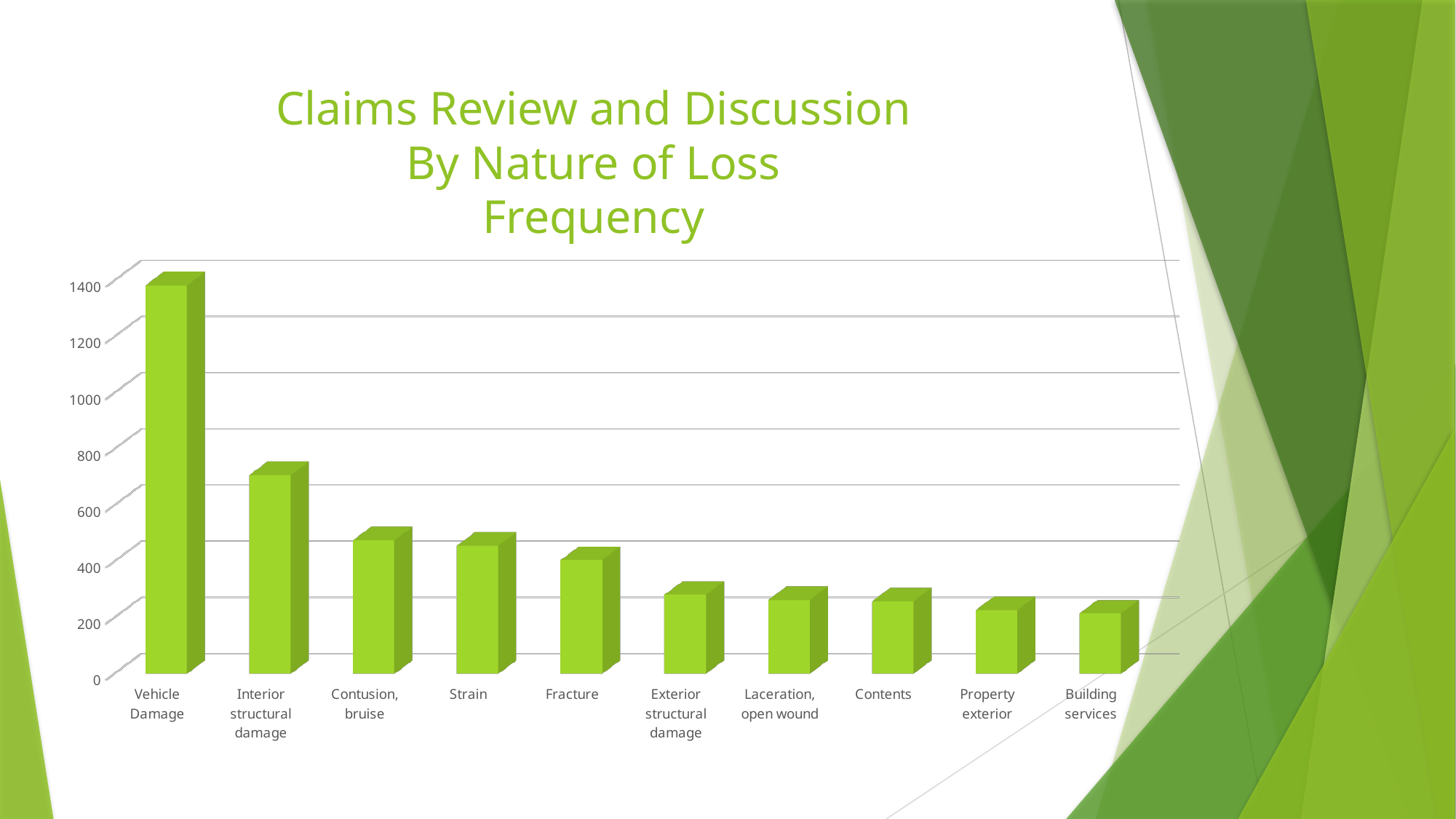
Is the value for Interior structural damage greater or less than 600? greater Do the values generally rise or fall moving from left to right along the x axis? fall Is the value for Interior structural damage greater or less than 800? less Is the value for Building services greater or less than 400? less How many categories are plotted on the chart? 10 What is the title of the chart on the slide? Claims Review and Discussion By Nature of Loss Frequency What kind of chart is shown on the slide? bar chart Which is larger, the value for Vehicle Damage or the value for Interior structural damage? Vehicle Damage Which category has the highest frequency? Vehicle Damage